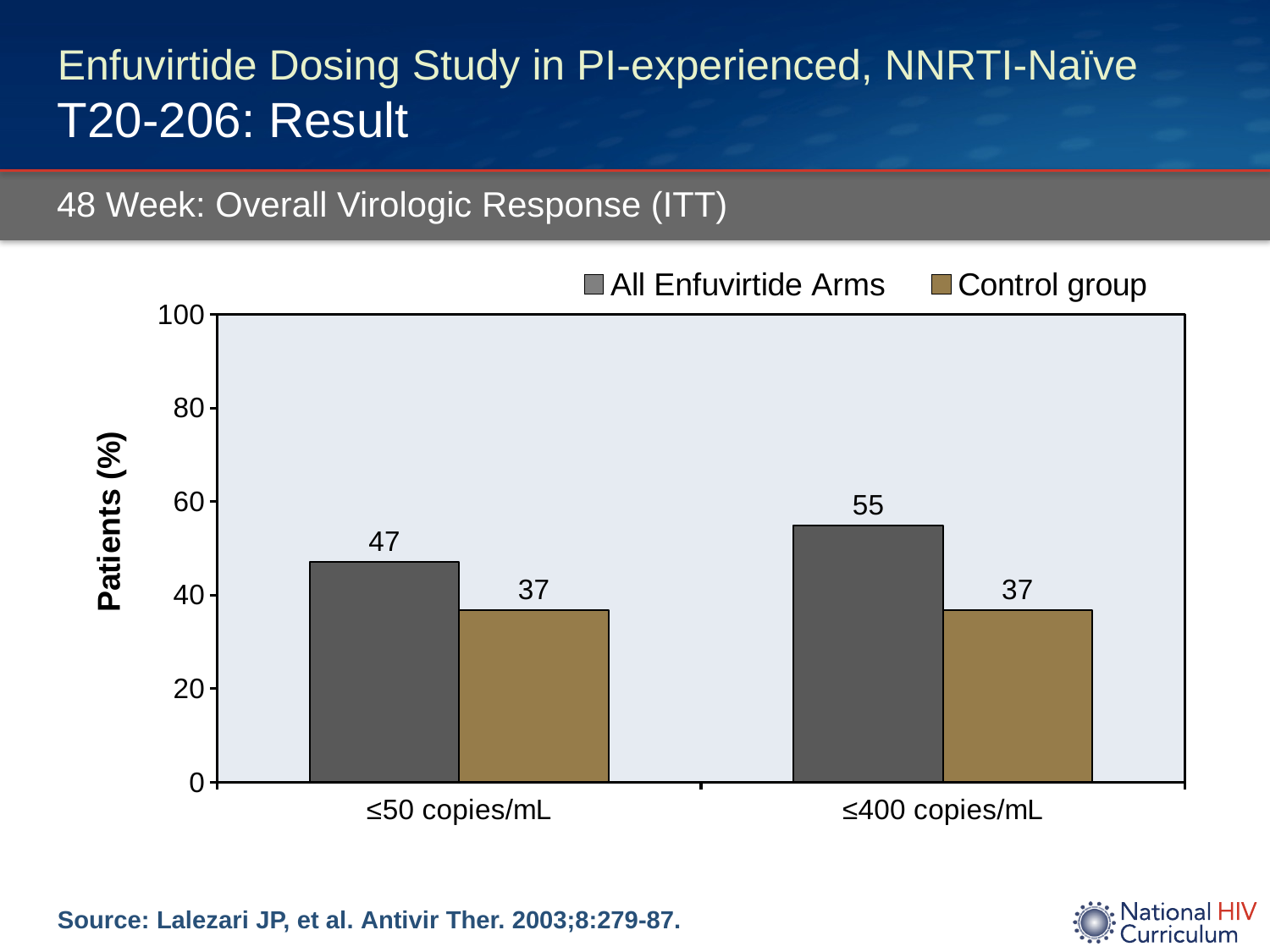
What is the label of the y axis? Patients (%) What is the value for All Enfuvirtide Arms at ≤400 copies/mL? 55 Is the value for All Enfuvirtide Arms at ≤400 copies/mL greater or less than 60? less Which category has the highest value for All Enfuvirtide Arms? ≤400 copies/mL What is the value for the Control group at ≤400 copies/mL? 37 How many series does the legend list? 2 What kind of chart is shown on the slide? Bar chart What is the difference between All Enfuvirtide Arms and the Control group at ≤50 copies/mL? 10 How many categories are shown on the x axis? 2 What is the difference between All Enfuvirtide Arms and the Control group at ≤400 copies/mL? 18 What is the value for All Enfuvirtide Arms at ≤50 copies/mL? 47 Which is larger at ≤50 copies/mL: All Enfuvirtide Arms or the Control group? All Enfuvirtide Arms